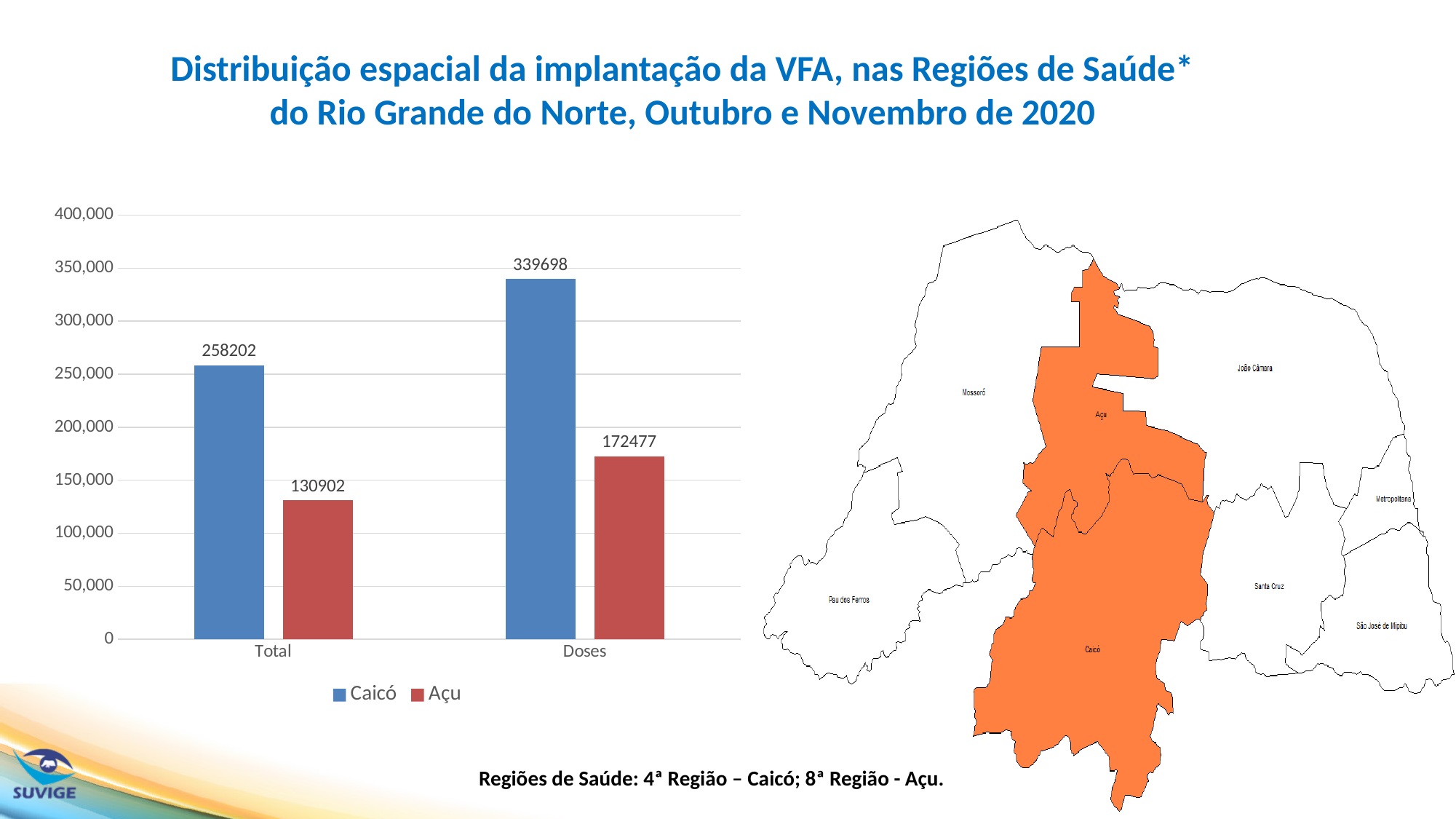
What kind of chart is shown on the slide? Bar chart What colour represents Açu in the chart? Red What is the difference between Caicó and Açu in the Doses category? 167221 Which bar has the lowest value in the chart? Açu, Total What is the value for Caicó in the Total category? 258202 What is the value for Açu in the Doses category? 172477 What is the value for Caicó in the Doses category? 339698 How many series does the legend list? 2 Which is larger in the Total category, Caicó or Açu? Caicó What is the difference between the Caicó values for Doses and Total? 81496 What is the value for Açu in the Total category? 130902 Which bar has the highest value in the chart? Caicó, Doses